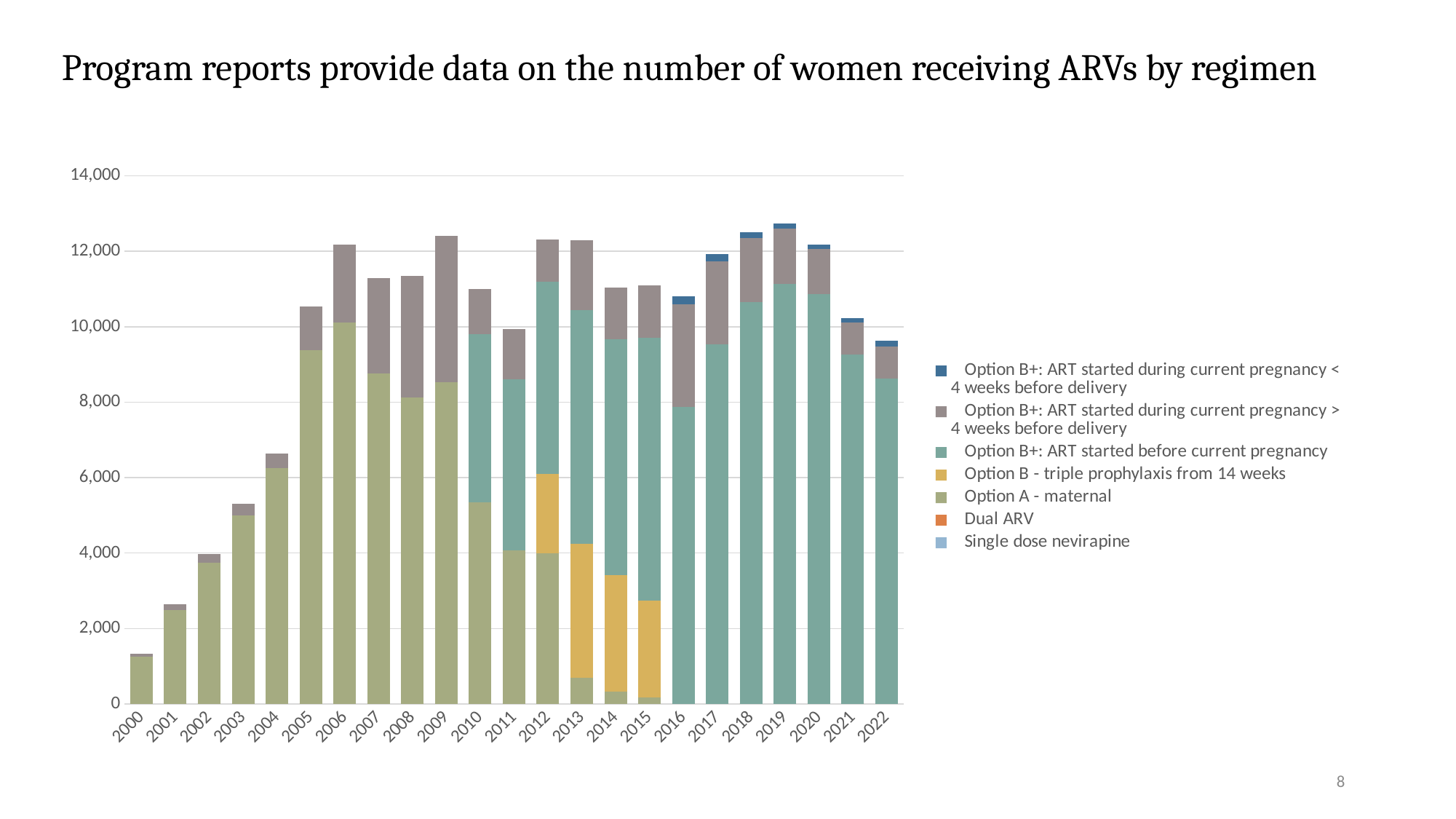
Which legend entry is shown in yellow/gold? Option B - triple prophylaxis from 14 weeks Do the total bar heights rise or fall from 2000 to 2006? rise Which year has the larger total bar, 2019 or 2022? 2019 How many years are shown along the x axis of the chart? 23 Which year has the lowest total number of women receiving ARVs? 2000 Which year has the larger total bar, 2004 or 2005? 2005 Is the total value for 2022 greater or less than 10,000? less What kind of chart is shown on the slide? Stacked bar chart Is the total value for 2005 greater or less than 10,000? greater Is the total value for 2004 greater or less than 6,000? greater How many series does the chart's legend list? 7